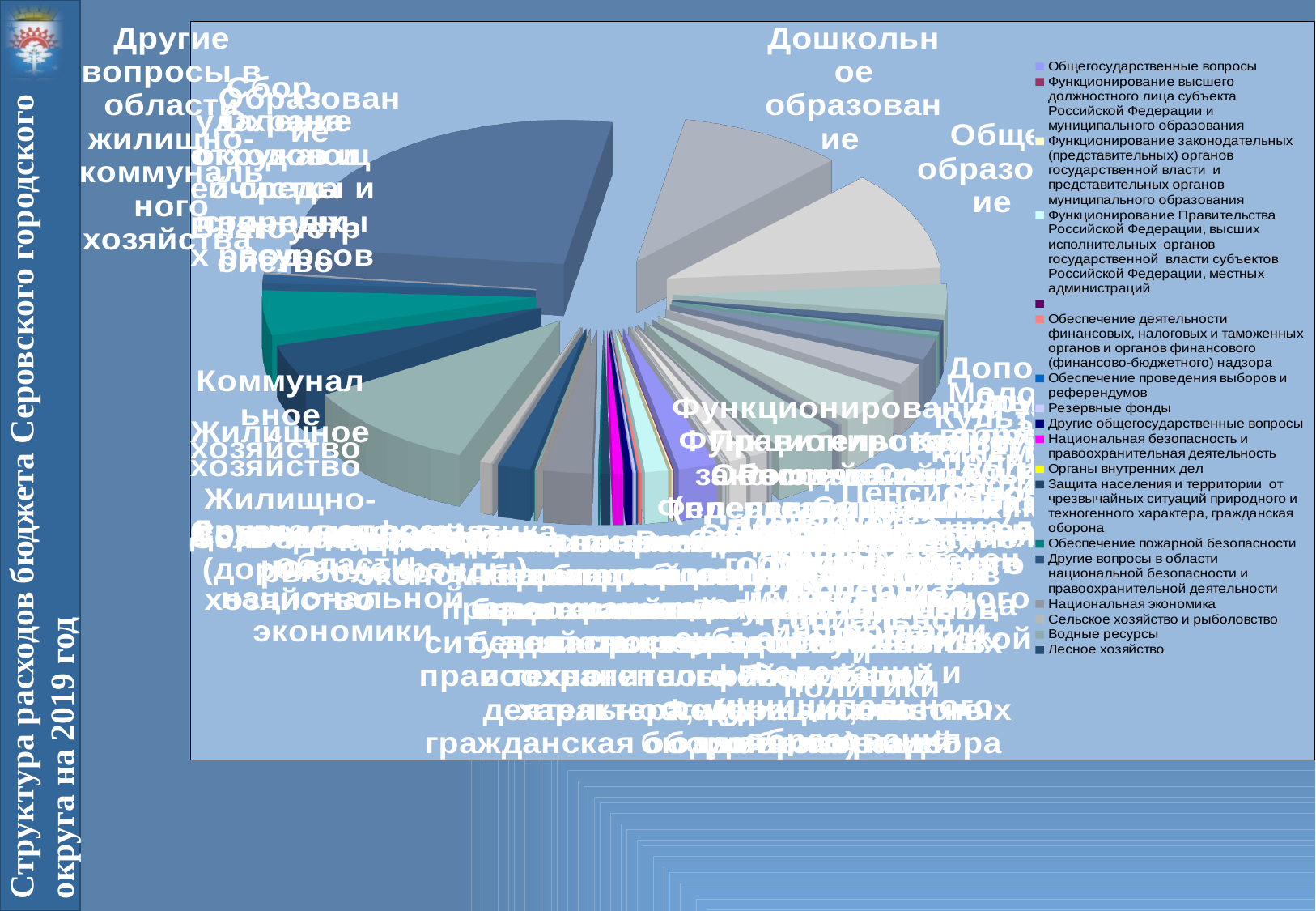
What kind of chart is shown on the slide? pie chart What is the title of the slide containing the pie chart? Структура расходов бюджета Серовского городского округа на 2019 год What is the first entry listed in the chart's legend? Общегосударственные вопросы What is the last entry listed in the chart's legend? Лесное хозяйство Which colour does the legend use for "Органы внутренних дел"? yellow